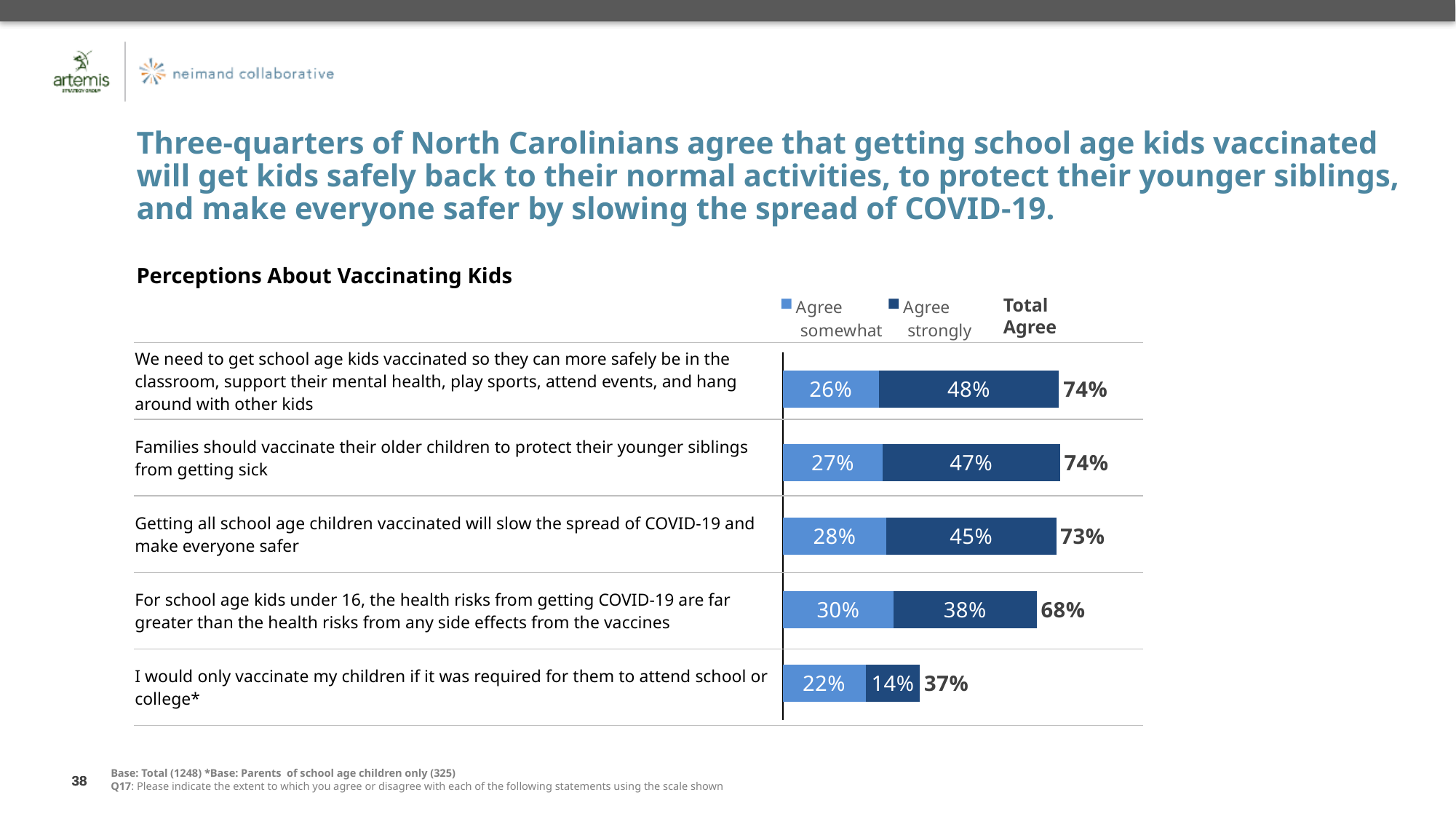
How many series does the legend list? 2 Which is larger: the 'Agree strongly' share for the younger siblings statement or the 'Agree strongly' share for the slow the spread statement? Younger siblings statement (47%) What percentage agree somewhat that families should vaccinate their older children to protect their younger siblings from getting sick? 27% What type of chart is shown on the slide? Stacked horizontal bar chart What percentage agree strongly that we need to get school age kids vaccinated so they can more safely be in the classroom? 48% What is the difference between the 'Agree strongly' percentages for the classroom statement (48%) and the health risks for kids under 16 statement (38%)? 10% What is the title of the chart? Perceptions About Vaccinating Kids What percentage agree strongly that they would only vaccinate their children if it was required for them to attend school or college? 14% What is the Total Agree for the statement that getting all school age children vaccinated will slow the spread of COVID-19 and make everyone safer? 73% Which statement has the highest 'Agree somewhat' percentage? For school age kids under 16, the health risks from getting COVID-19 are far greater than the health risks from any side effects from the vaccines Which statement has the lowest Total Agree? I would only vaccinate my children if it was required for them to attend school or college* How many statements are shown in the chart? 5